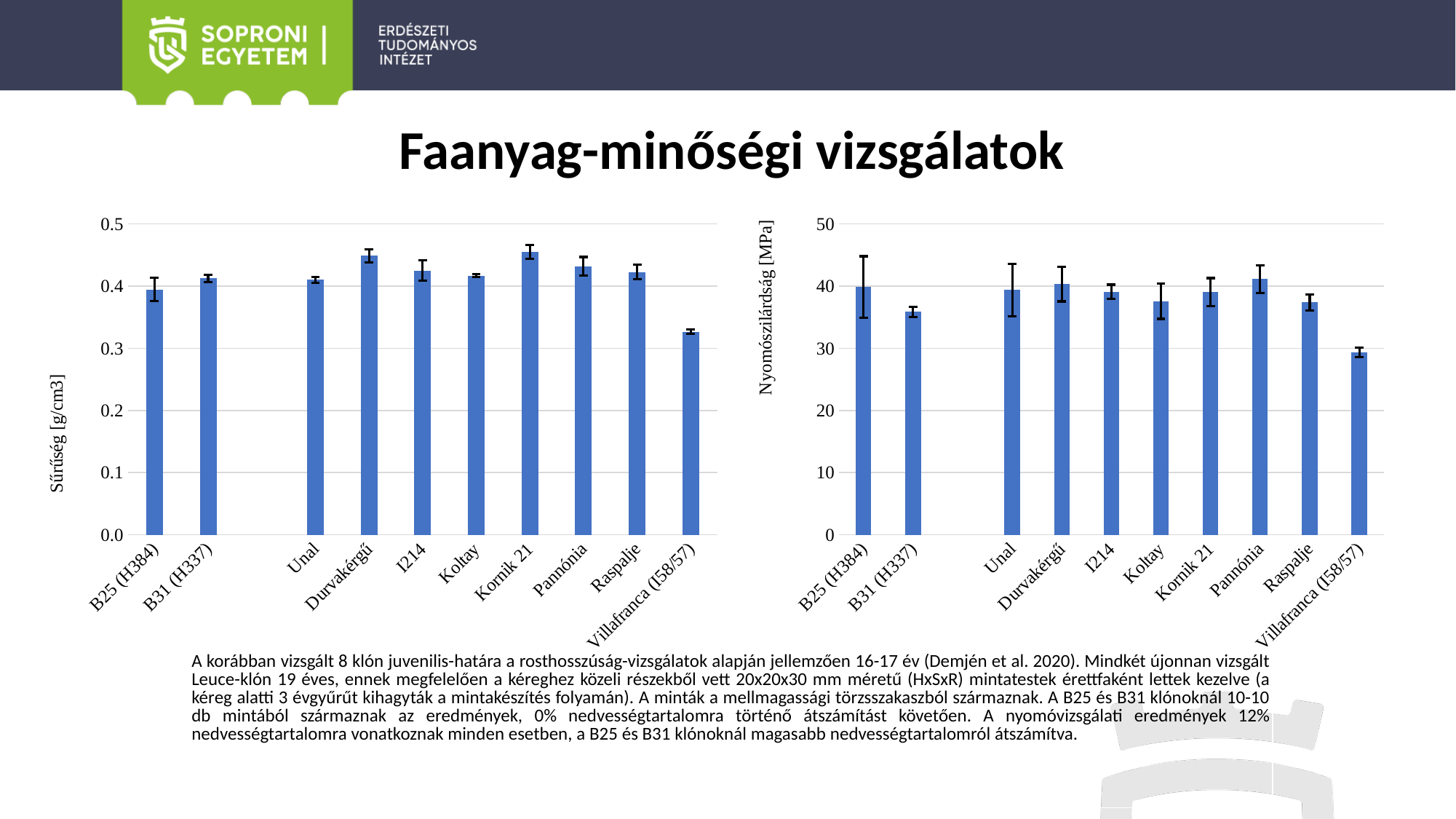
On the right chart (Nyomószilárdság), which clone has the lowest compressive strength? Villafranca (I58/57) On the right chart (Nyomószilárdság), is the value for Villafranca (I58/57) greater or less than 40? less On the right chart (Nyomószilárdság), is the value for B31 (H337) greater or less than 30? greater How many categories are shown on the right chart (Nyomószilárdság)? 10 What kind of chart is the left chart on the slide? bar chart What is the y-axis label of the right chart? Nyomószilárdság [MPa] On the left chart (Sűrűség), is the value for Durvakérgű greater or less than 0.4? greater On the left chart (Sűrűség), which clone has the lowest density? Villafranca (I58/57) On the right chart (Nyomószilárdság), which is larger, the value for B31 (H337) or the value for Villafranca (I58/57)? B31 (H337) On the left chart (Sűrűség), which is larger, the value for Koltay or the value for Villafranca (I58/57)? Koltay How many clones (categories) are shown on the left chart (Sűrűség)? 10